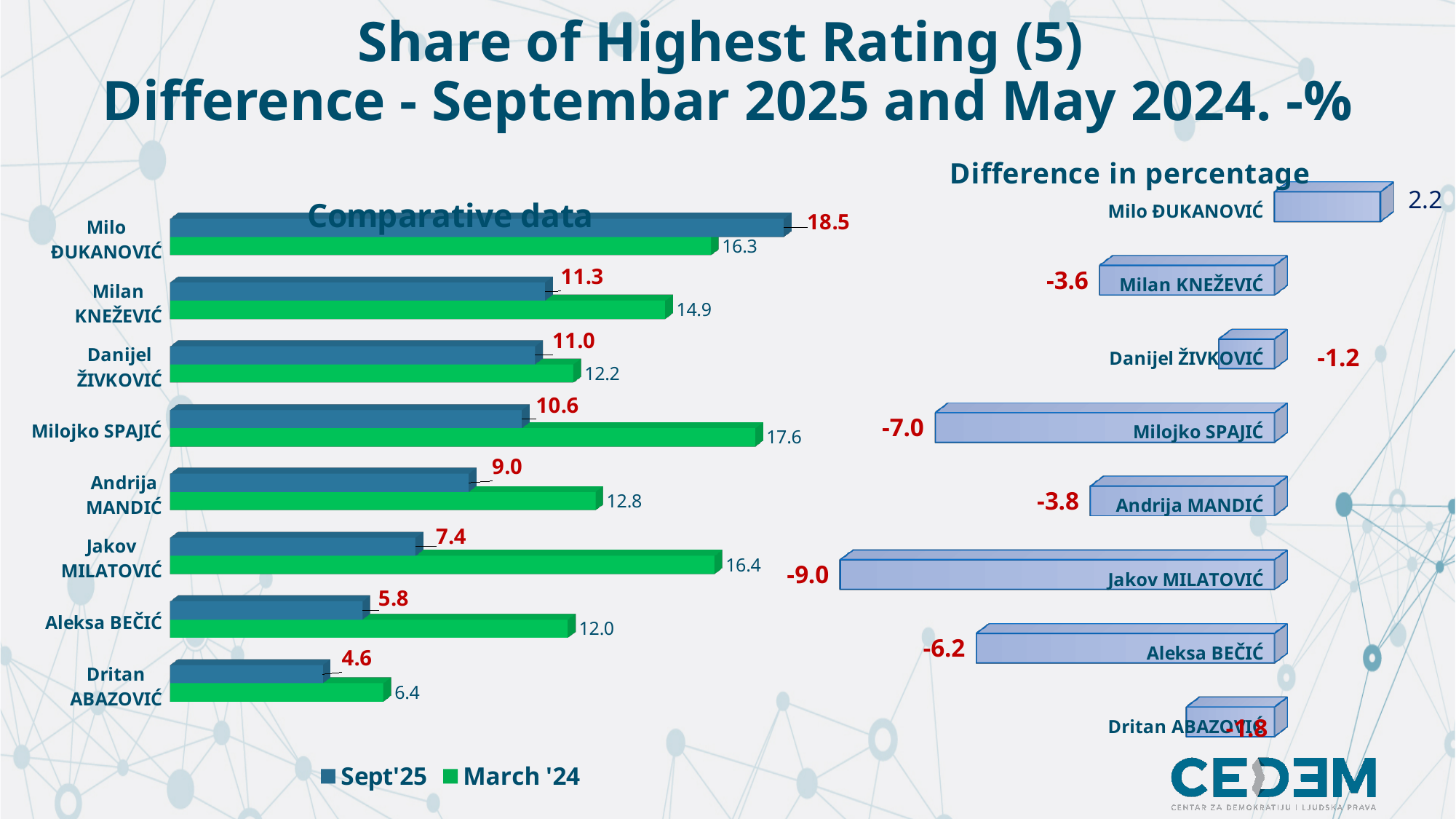
How many series does the legend of the Comparative data chart list? 2 In the Comparative data chart, what is the difference between the March '24 and Sept'25 values for Jakov MILATOVIĆ? 9.0 In the Difference in percentage chart, what is the value for Jakov MILATOVIĆ? -9.0 In the Comparative data chart, which person has the highest March '24 value? Milojko SPAJIĆ In the Comparative data chart, what is the March '24 value for Milojko SPAJIĆ? 17.6 In the Difference in percentage chart, which person has the only positive value? Milo ĐUKANOVIĆ In the Comparative data chart, which person has the lowest Sept'25 value? Dritan ABAZOVIĆ What kind of chart is the Comparative data chart? Bar chart In the Comparative data chart, what is the Sept'25 value for Milo ĐUKANOVIĆ? 18.5 In the Difference in percentage chart, what is the value for Aleksa BEČIĆ? -6.2 How many people are shown in the Comparative data chart? 8 In the Comparative data chart, is the Sept'25 value or the March '24 value larger for Milo ĐUKANOVIĆ? Sept'25